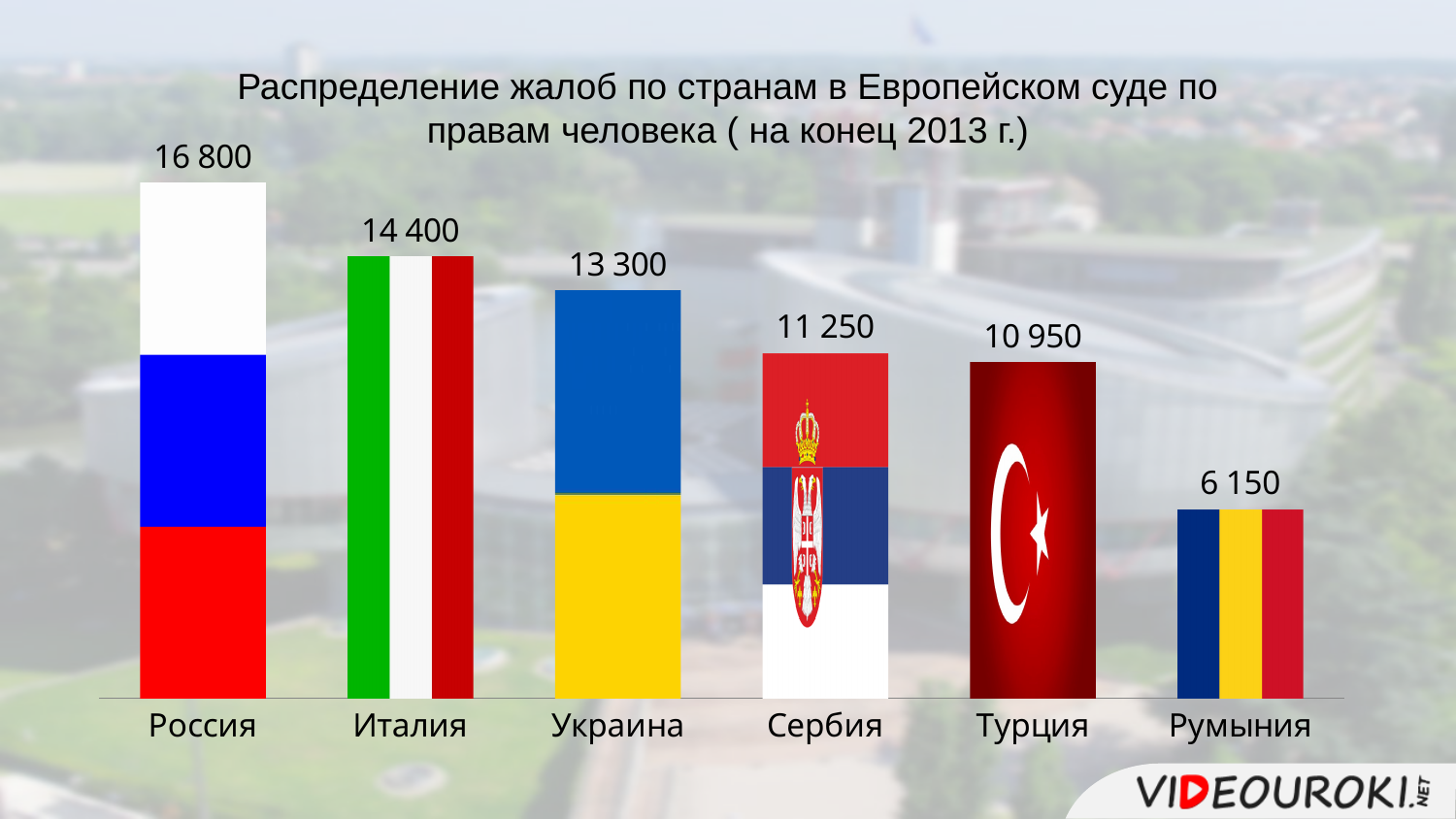
What is the title of the chart? Распределение жалоб по странам в Европейском суде по правам человека ( на конец 2013 г.) Which is larger, the value for Украина or the value for Сербия? Украина What is the value for Румыния? 6 150 What is the difference between the values for Россия and Италия? 2 400 How many countries are shown in the chart? 6 Which country has the lowest number of complaints? Румыния Do the values rise or fall from left to right along the x axis? fall What is the value for Россия? 16 800 What kind of chart is shown on the slide? bar chart What is the value for Сербия? 11 250 What is the difference between the values for Турция and Румыния? 4 800 Which country has the highest number of complaints? Россия